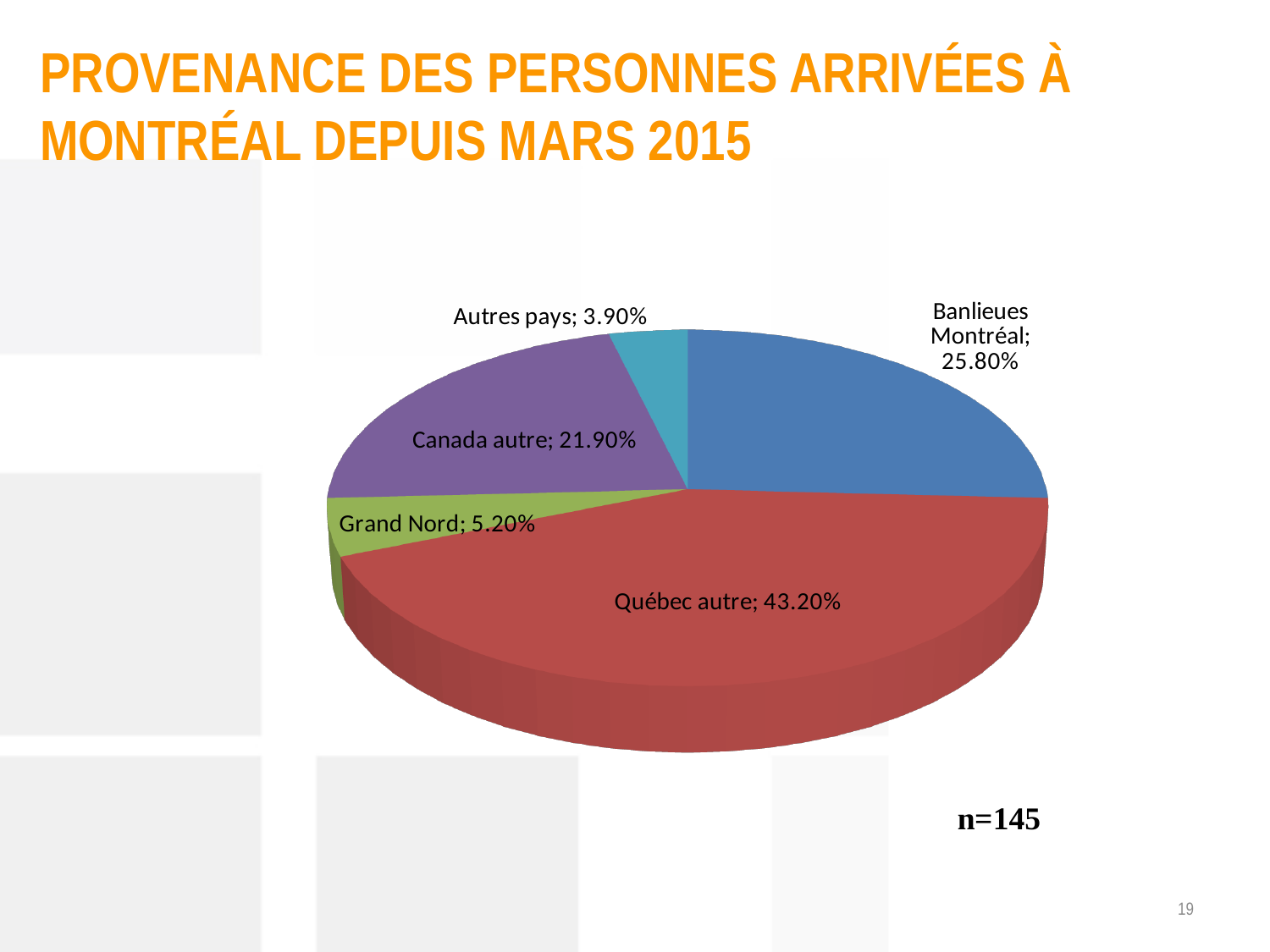
What type of chart is shown on the slide? Pie chart What sample size (n) is indicated on the slide? n=145 How many categories are shown in the pie chart? 5 What percentage is labelled for Canada autre? 21.90% What is the value shown for Banlieues Montréal? 25.80% What is the difference between the Québec autre and Banlieues Montréal shares? 17.40% What is the value for Autres pays? 3.90% Which is larger, Canada autre or Banlieues Montréal? Banlieues Montréal Which category has the smallest slice of the pie? Autres pays Which category has the largest slice of the pie? Québec autre What is the value for Grand Nord? 5.20% What share of the pie does Québec autre represent? 43.20%